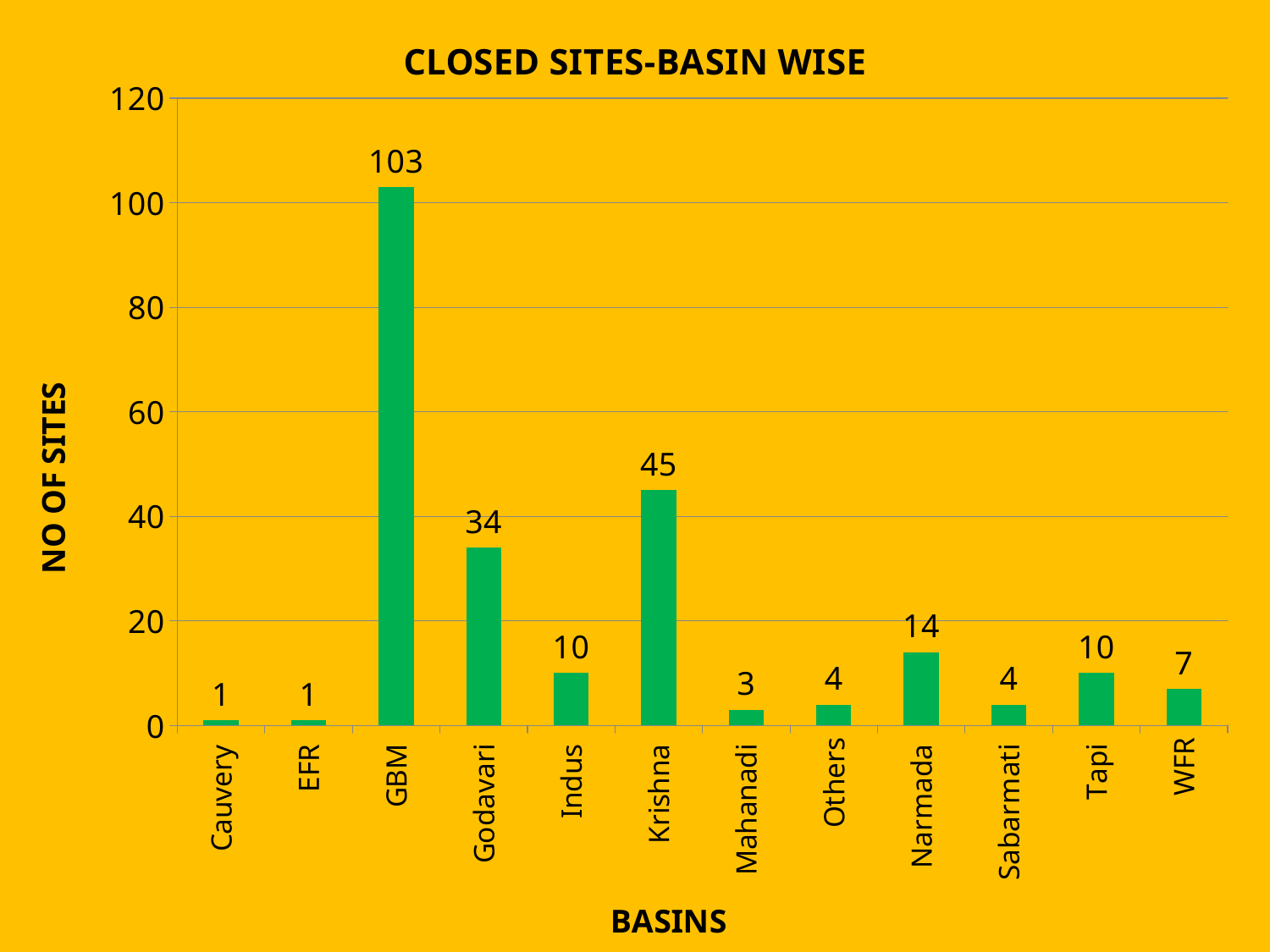
What kind of chart is shown on the slide? bar chart Is the value for Krishna greater or less than 40? greater What is the difference in closed sites between GBM and Krishna? 58 What is the number of closed sites for the GBM basin? 103 What is the label of the y axis? NO OF SITES What is the number of closed sites for the Krishna basin? 45 How many basins are shown on the x axis? 12 Which has more closed sites, Godavari or Narmada? Godavari Which basin has the highest number of closed sites? GBM What is the difference in closed sites between Godavari and Indus? 24 What is the number of closed sites for the Narmada basin? 14 What is the title of the chart? CLOSED SITES-BASIN WISE